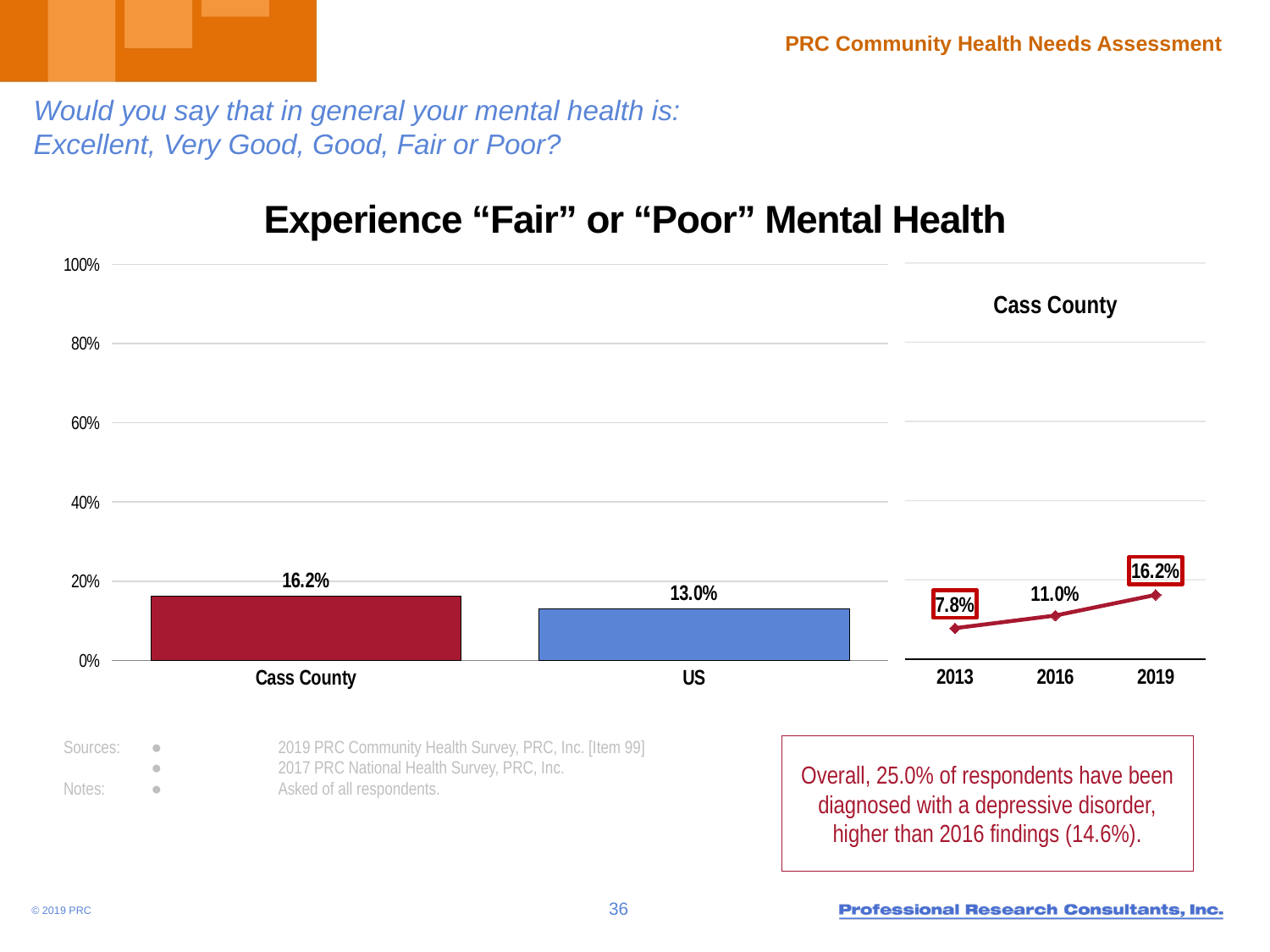
In the bar chart on the left, which category has the higher value, Cass County or US? Cass County In the Cass County trend chart on the right, do the values rise or fall from 2013 to 2019? rise How many categories are shown in the bar chart on the left? 2 In the Cass County trend chart on the right, what is the value for 2013? 7.8% In the bar chart on the left, what is the value for Cass County? 16.2% In the bar chart on the left, is the value for US greater or less than 20%? less What is the title of the chart on the slide? Experience "Fair" or "Poor" Mental Health What kind of chart is the chart on the left? bar chart In the bar chart on the left, what is the value for US? 13.0% In the Cass County trend chart on the right, which year has the lowest value? 2013 In the bar chart on the left, what is the difference between the Cass County and US values? 3.2% In the Cass County trend chart on the right, what is the value for 2016? 11.0%